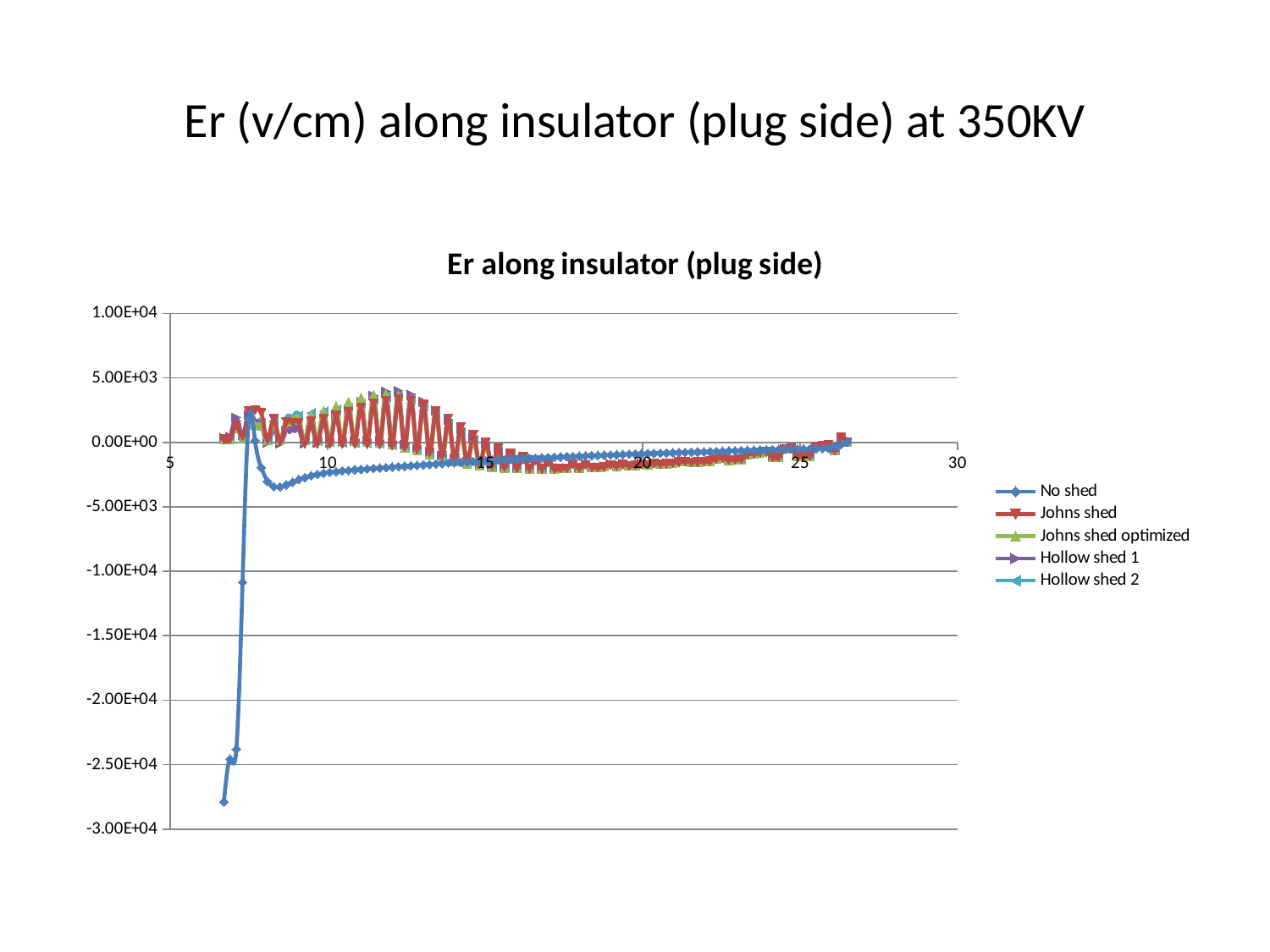
Is the value of the No shed series at x = 10 greater or less than 0.00E+00? less Is the highest value of the Johns shed series greater or less than 5.00E+03? less Which series reaches the lowest value on the chart? No shed How many series does the legend list? 5 Is the lowest value of the No shed series greater or less than -2.50E+04? less Which series is listed last in the legend? Hollow shed 2 What kind of chart is shown on the slide? line chart Does the No shed series rise or fall between x = 6 and x = 8? rise What is the highest value shown on the vertical axis? 1.00E+04 What is the title printed inside the chart area? Er along insulator (plug side)